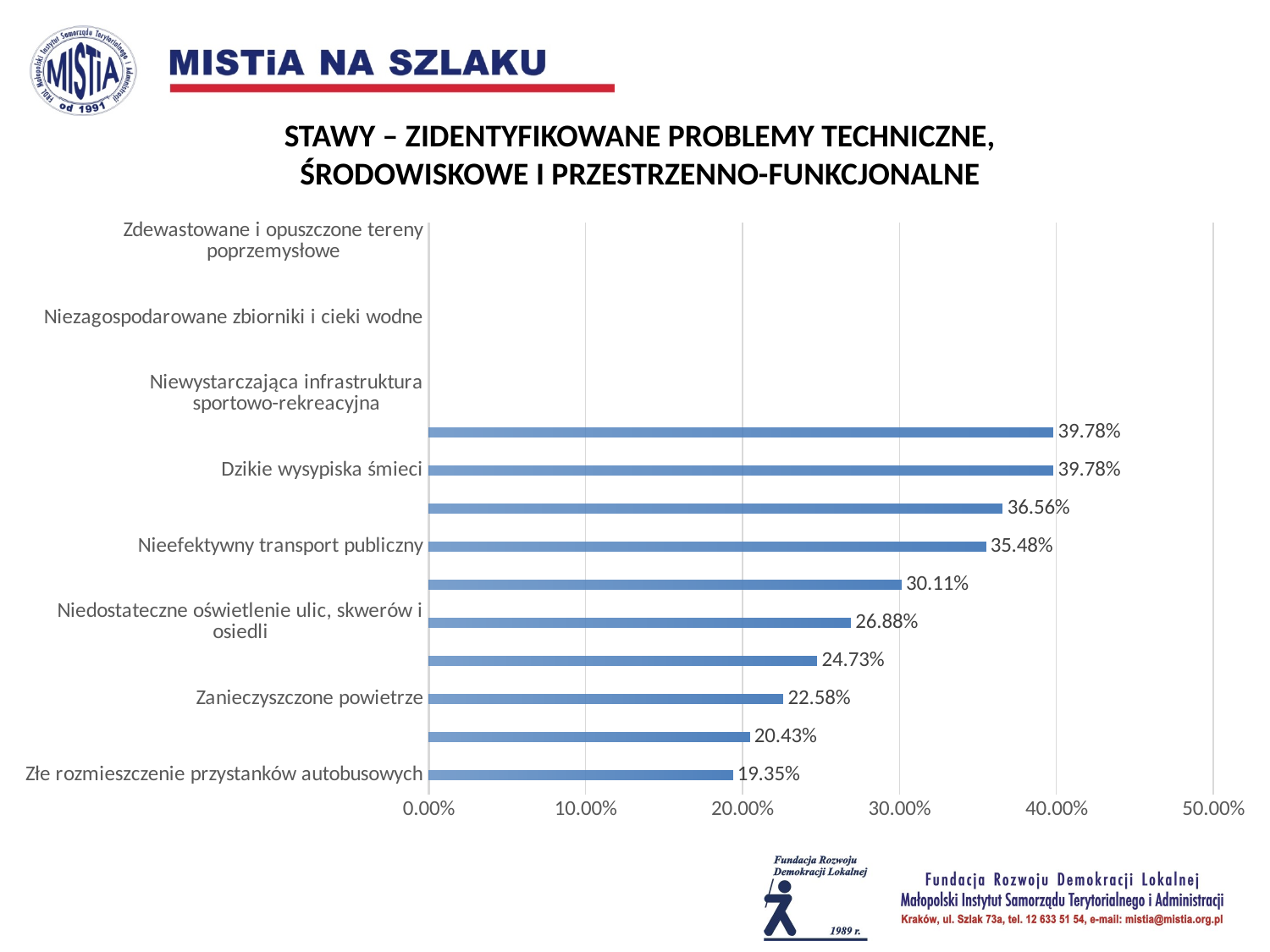
What kind of chart is shown on the slide? bar chart What is the highest value shown by a data label in the chart? 39.78% What is the value for Niedostateczne oświetlenie ulic, skwerów i osiedli? 26.88% What is the value for Dzikie wysypiska śmieci? 39.78% What is the value for Złe rozmieszczenie przystanków autobusowych? 19.35% What is the maximum value shown on the horizontal axis of the chart? 50.00% Is the value for Nieefektywny transport publiczny greater or less than 30.00%? greater Which is larger, the value for Nieefektywny transport publiczny or the value for Niedostateczne oświetlenie ulic, skwerów i osiedli? Nieefektywny transport publiczny What is the difference between the values for Dzikie wysypiska śmieci and Zanieczyszczone powietrze? 17.20% What is the value for Nieefektywny transport publiczny? 35.48% Which category has the lowest value in the chart? Złe rozmieszczenie przystanków autobusowych What is the value for Zanieczyszczone powietrze? 22.58%